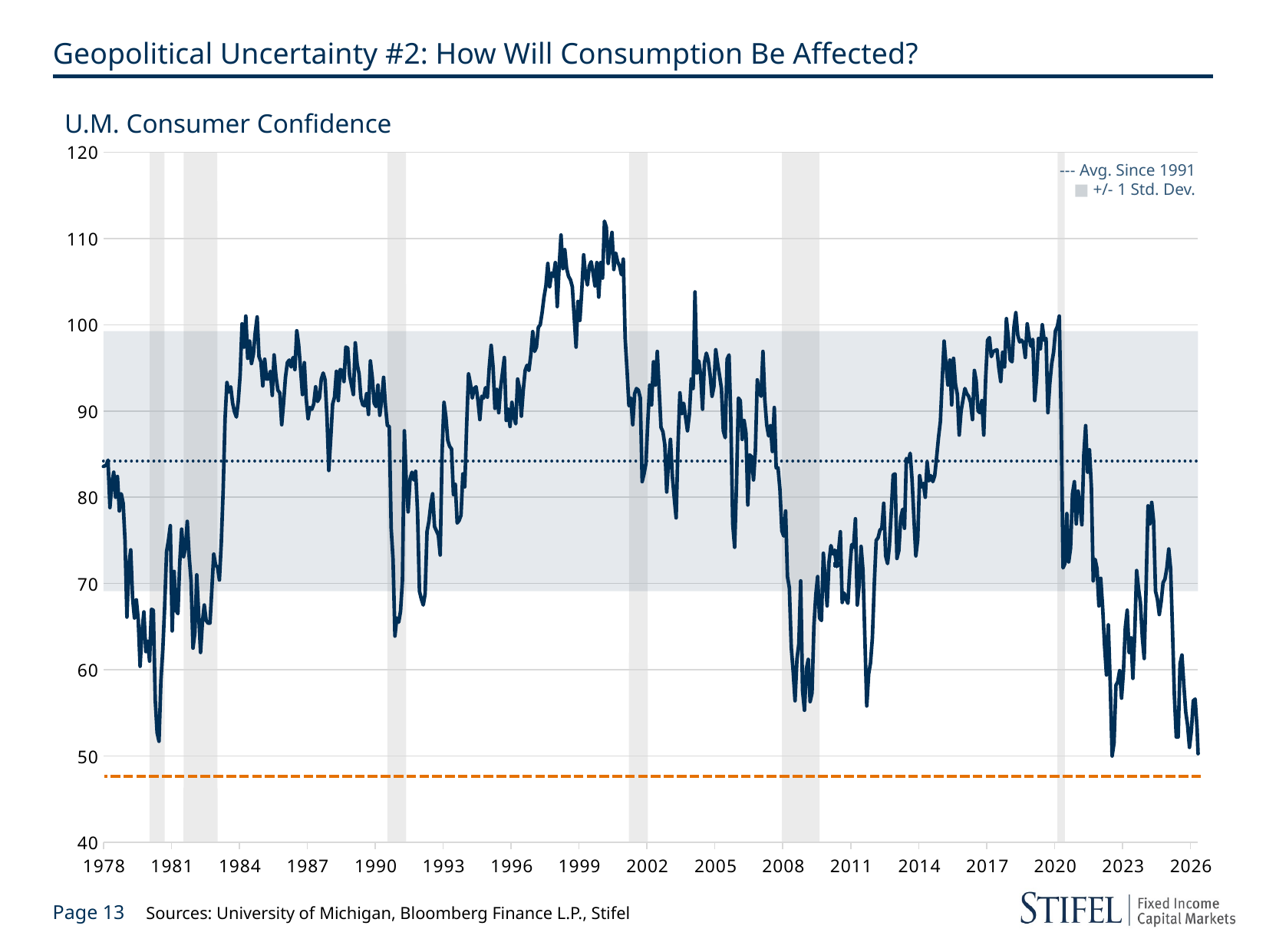
What is the title of the chart? U.M. Consumer Confidence Does consumer confidence generally rise or fall between 1991 and 1999? rise What does the shaded horizontal band in the chart represent, according to the legend? +/- 1 Std. Dev. Is the peak around 2000 higher or lower than the peak around 2019? higher How many entries does the chart's legend list? 2 What kind of chart is shown on the slide? Line chart Is the 'Avg. Since 1991' dotted line greater or less than 80? greater Is the peak value of consumer confidence around 2000 greater or less than 100? greater Is the trough in consumer confidence around 2009 greater or less than 60? less Does consumer confidence generally rise or fall between 2020 and 2026? fall